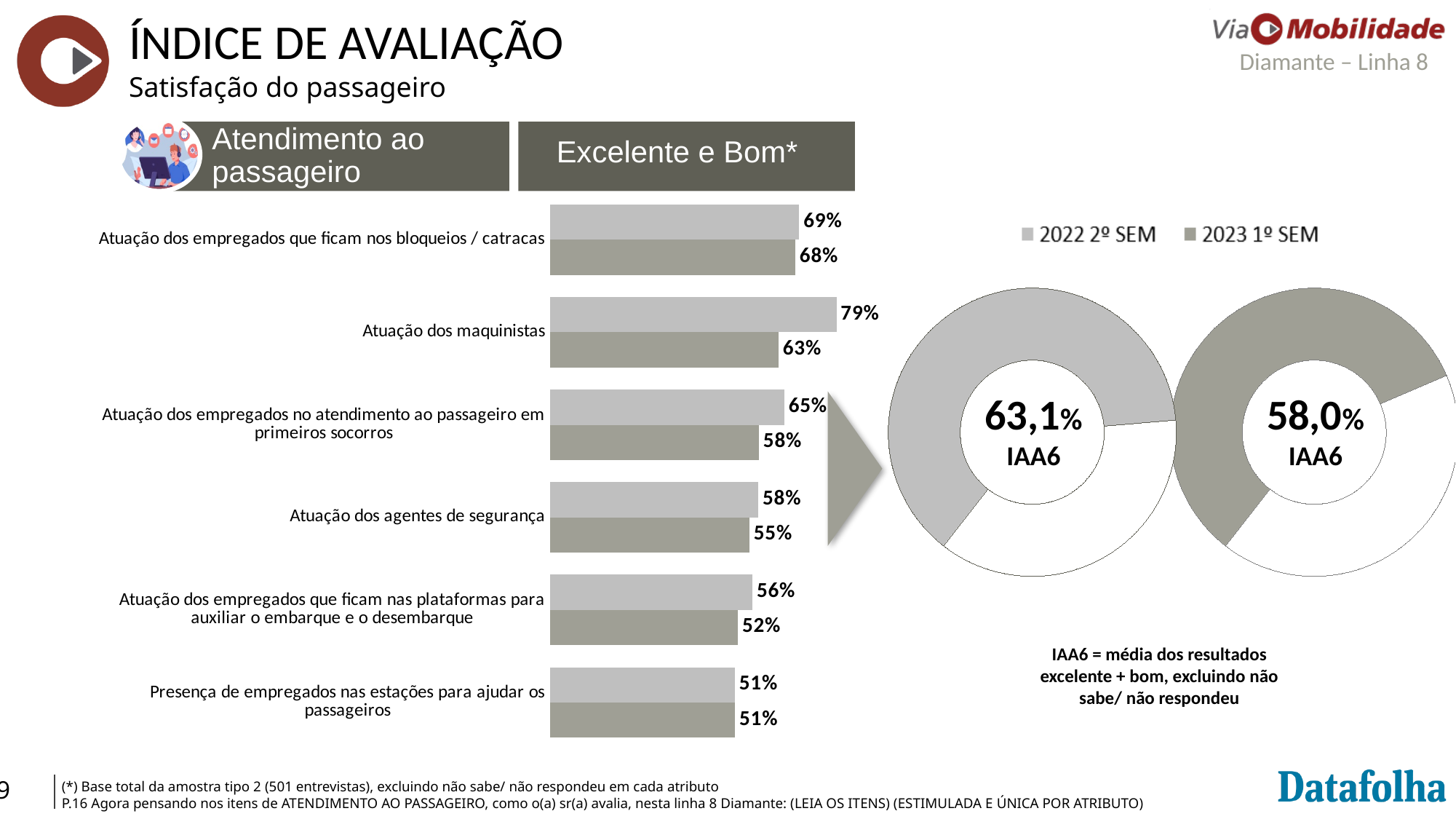
In the bar chart, which is larger for 'Atuação dos empregados que ficam nas plataformas para auxiliar o embarque e o desembarque': the 2022 2º SEM value or the 2023 1º SEM value? 2022 2º SEM What is the difference between the IAA6 values shown in the left and right donut charts? 5,1% In the bar chart, which category has the highest 2022 2º SEM value? Atuação dos maquinistas In the bar chart, what is the 2023 1º SEM value for 'Atuação dos maquinistas'? 63% What kind of chart is used to show the 'Excelente e Bom*' results by category? Bar chart In the bar chart, what is the difference between the 2022 2º SEM and 2023 1º SEM values for 'Atuação dos maquinistas'? 16% In the right donut chart, what is the IAA6 value shown in the centre? 58,0% How many categories does the bar chart show? 6 In the bar chart, what is the 2022 2º SEM value for 'Atuação dos agentes de segurança'? 58% How many series does the legend list? 2 In the left donut chart, what is the IAA6 value shown in the centre? 63,1% In the bar chart, which category has the lowest 2023 1º SEM value? Presença de empregados nas estações para ajudar os passageiros